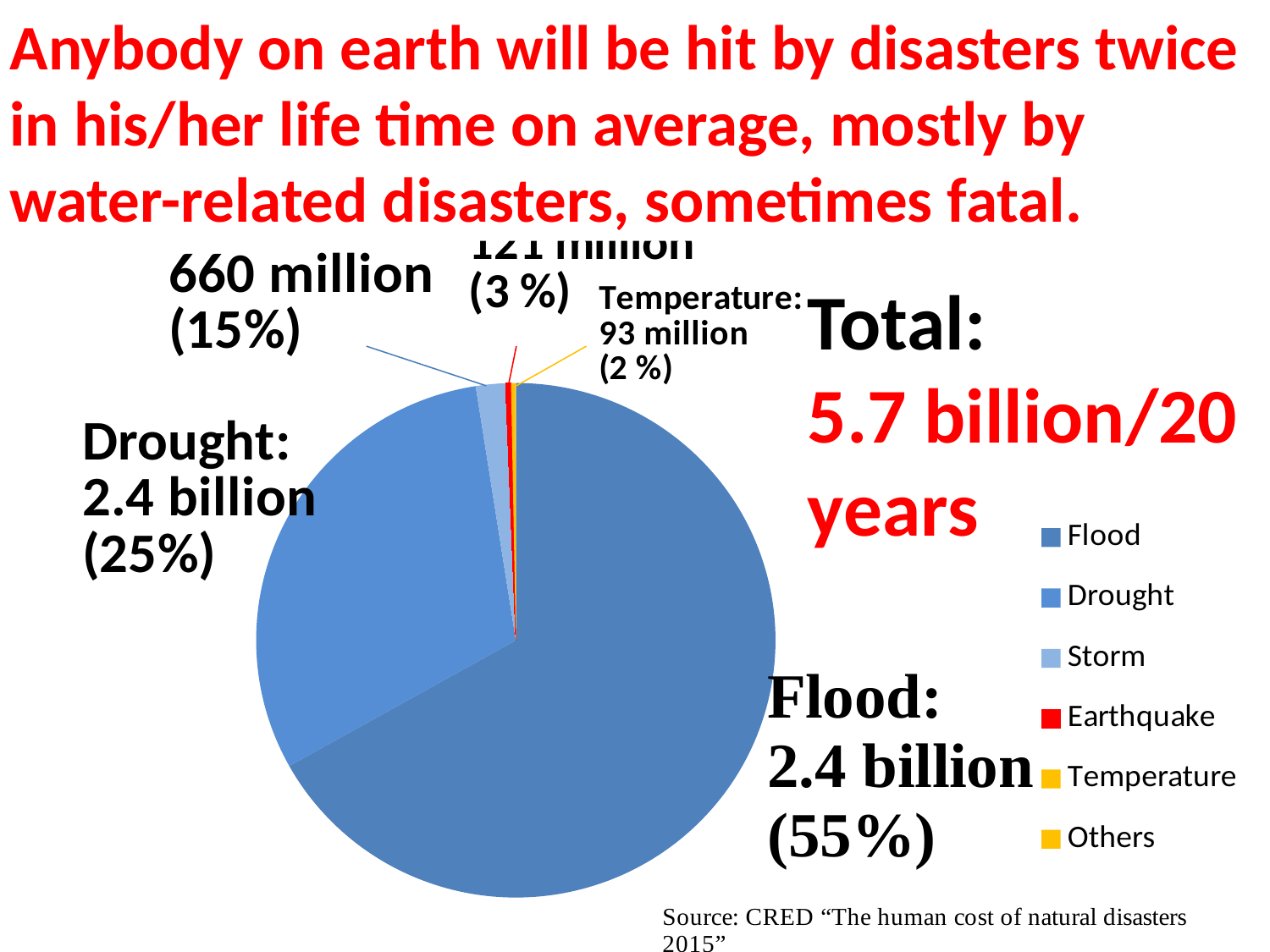
How many categories does the legend of the pie chart list? 6 What share of the pie does Temperature account for? 2 % What is the value shown for Temperature? 93 million What share of the pie does Drought account for? 25% What kind of chart is shown on the slide? pie chart What percentage is shown for the slice labelled 660 million? 15% What total is stated next to the pie chart? 5.7 billion/20 years What is the value shown for Drought? 2.4 billion Which category has the largest slice of the pie? Flood What colour represents Earthquake in the legend? red Which has the larger share of the pie, Flood or Drought? Flood